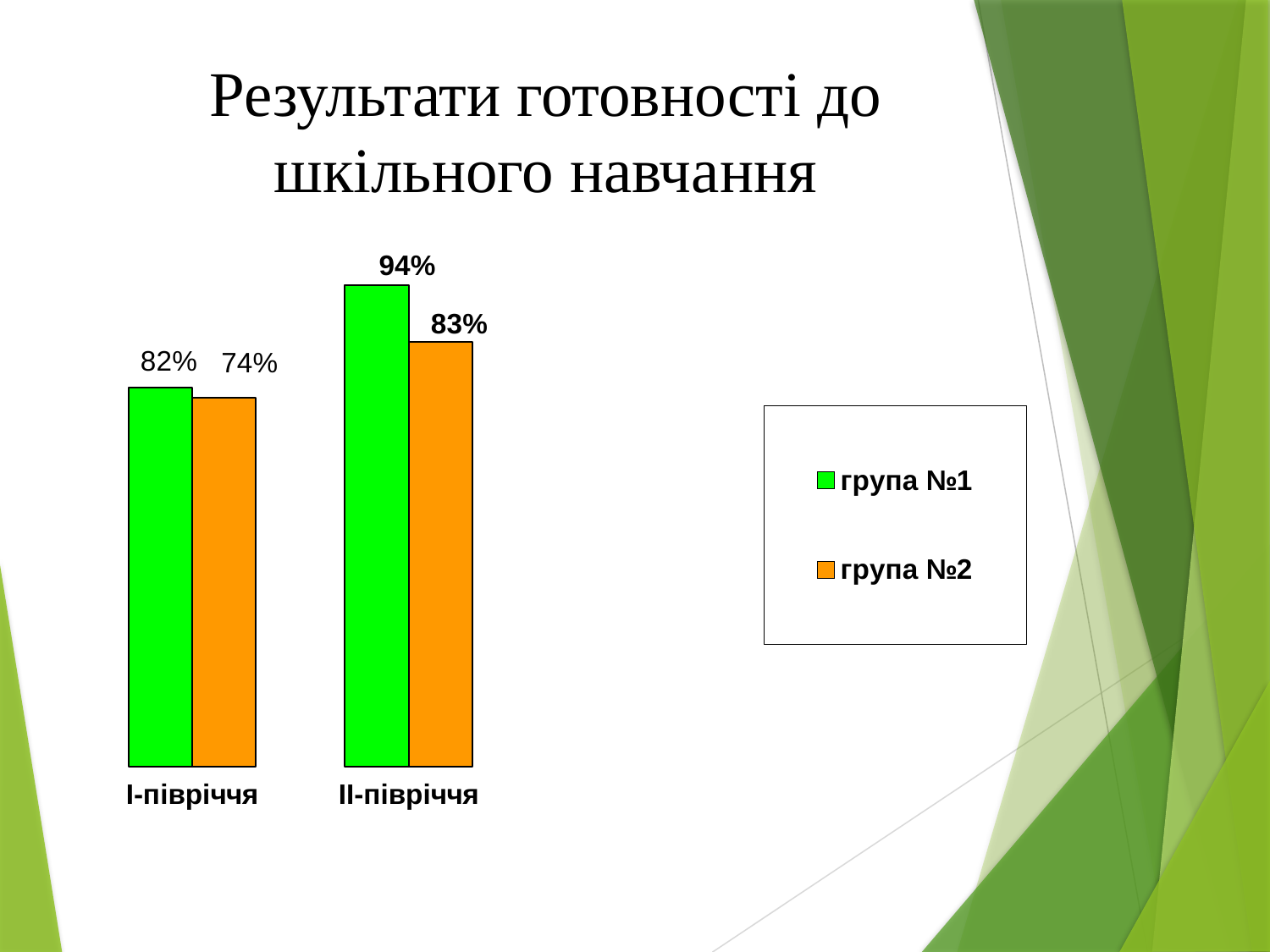
What is the value for група №2 in ІІ-півріччя? 83% How many categories are shown on the x axis? 2 What is the value for група №2 in І-півріччя? 74% What is the value for група №1 in І-півріччя? 82% Which is larger in І-півріччя, група №1 or група №2? група №1 How many series does the legend list? 2 What is the value for група №1 in ІІ-півріччя? 94% What kind of chart is shown on the slide? bar chart Which bar has the highest value on the chart? група №1 in ІІ-півріччя What is the difference between група №1 and група №2 in ІІ-півріччя? 11% By how much did група №1 increase from І-півріччя to ІІ-півріччя? 12% Which bar has the lowest value on the chart? група №2 in І-півріччя